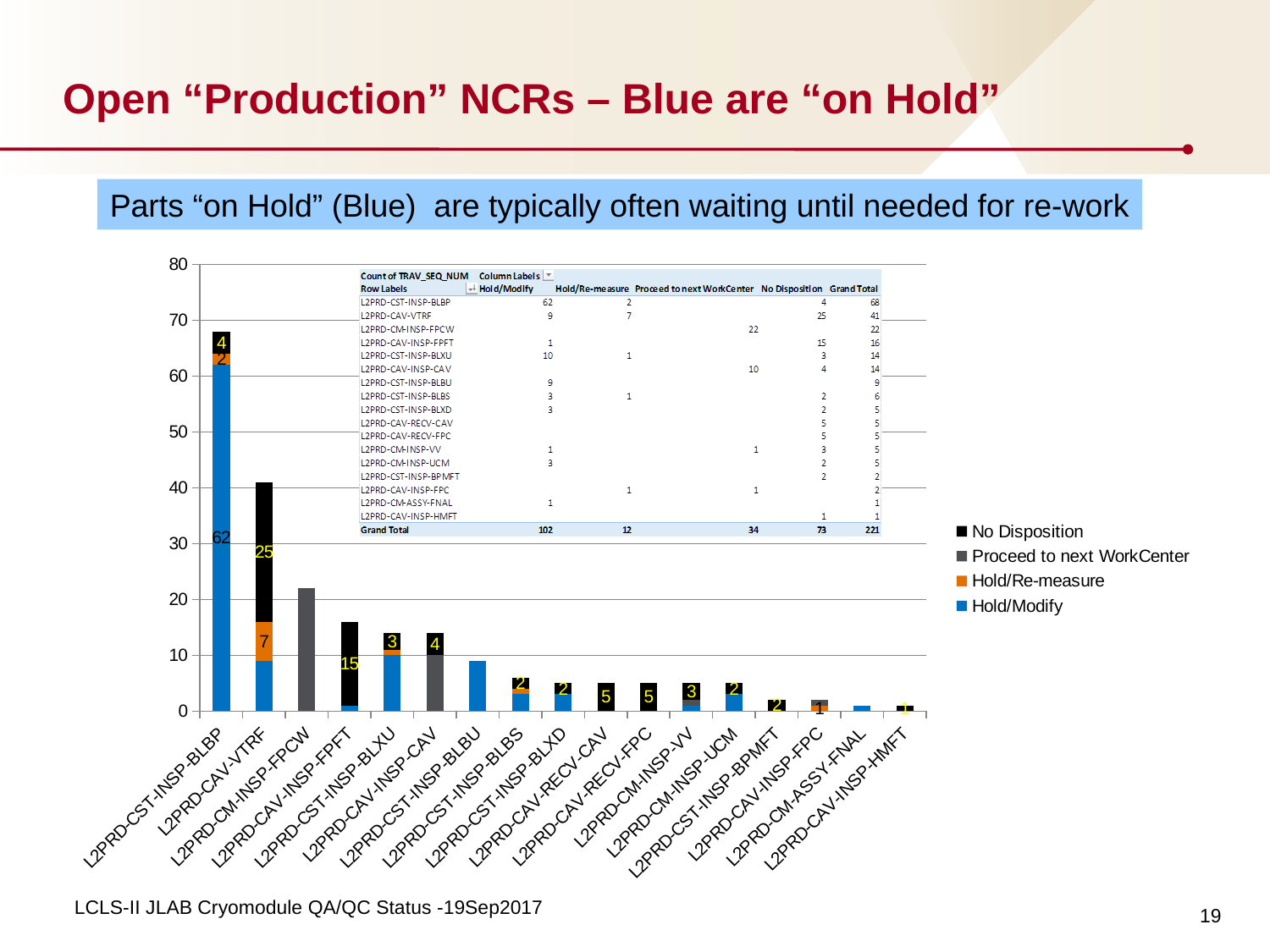
What is the difference between the No Disposition values for L2PRD-CAV-VTRF and L2PRD-CST-INSP-BLBP? 21 What is the No Disposition value for L2PRD-CAV-VTRF? 25 Do the stacked bar totals rise or fall from left to right along the x axis? Fall Which category has the tallest stacked bar? L2PRD-CST-INSP-BLBP How many categories are plotted along the x axis of the chart? 17 What is the Hold/Modify value for L2PRD-CST-INSP-BLBP? 62 What is the No Disposition value for L2PRD-CAV-INSP-FPFT? 15 Which has the larger Hold/Re-measure value, L2PRD-CAV-VTRF or L2PRD-CST-INSP-BLBP? L2PRD-CAV-VTRF What is the total of the stacked bar for L2PRD-CST-INSP-BLBP? 68 What kind of chart is shown on the slide? Stacked bar chart How many series does the chart legend list? 4 Is the total bar height for L2PRD-CM-INSP-FPCW greater or less than 30? less